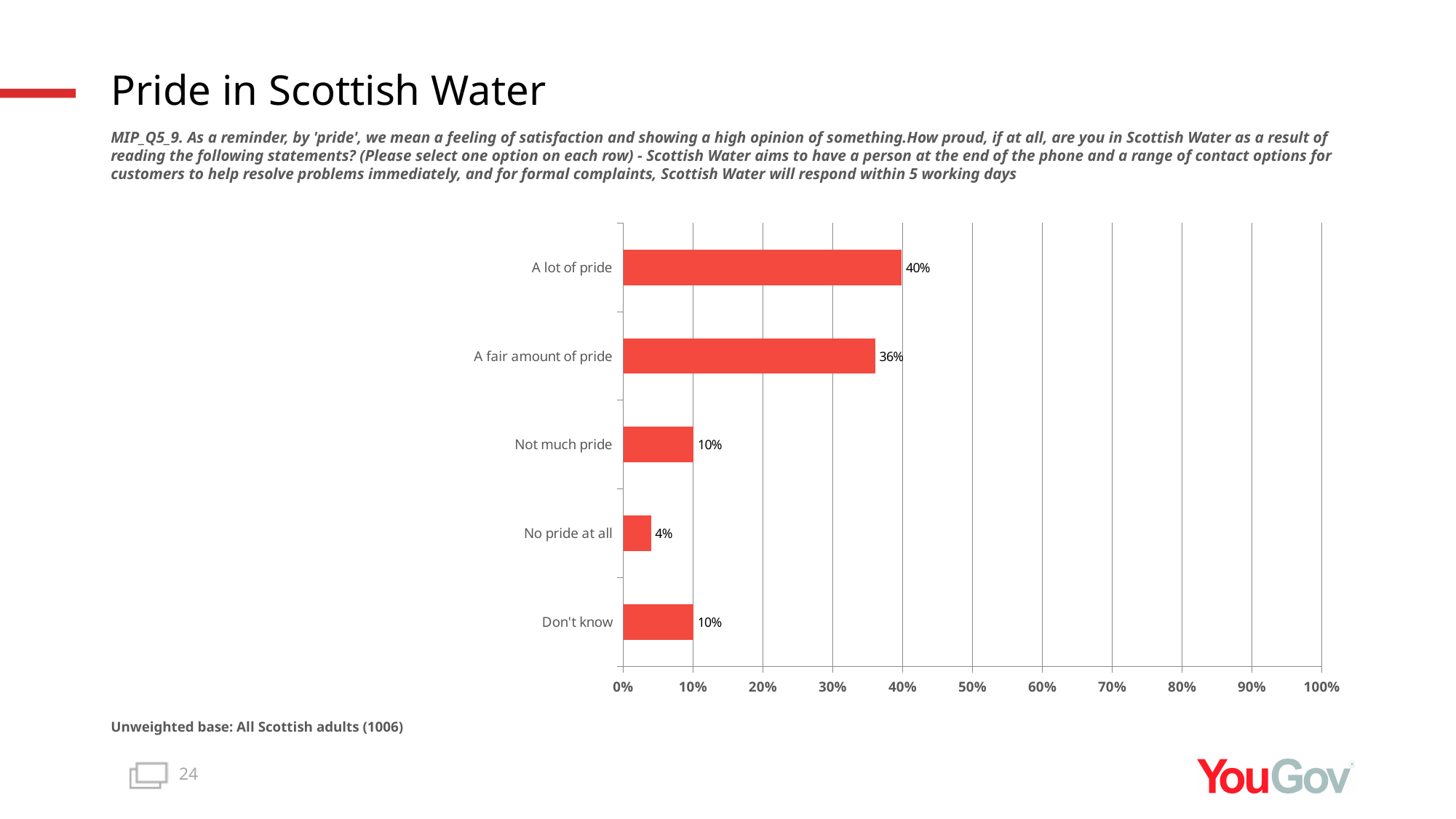
Which category has the highest value? A lot of pride What percentage of respondents said they have a lot of pride in Scottish Water? 40% Which is larger, 'Not much pride' or 'No pride at all'? Not much pride What is the value for 'No pride at all'? 4% What is the value for 'Don't know'? 10% What is the difference between 'A lot of pride' and 'A fair amount of pride'? 4 percentage points Which category has the lowest value? No pride at all What is the value for 'A fair amount of pride'? 36% What is the combined value of 'A lot of pride' and 'A fair amount of pride'? 76% How many categories are shown in the chart? 5 What kind of chart is shown on the slide? Bar chart Is the value for 'A fair amount of pride' greater or less than 30%? greater